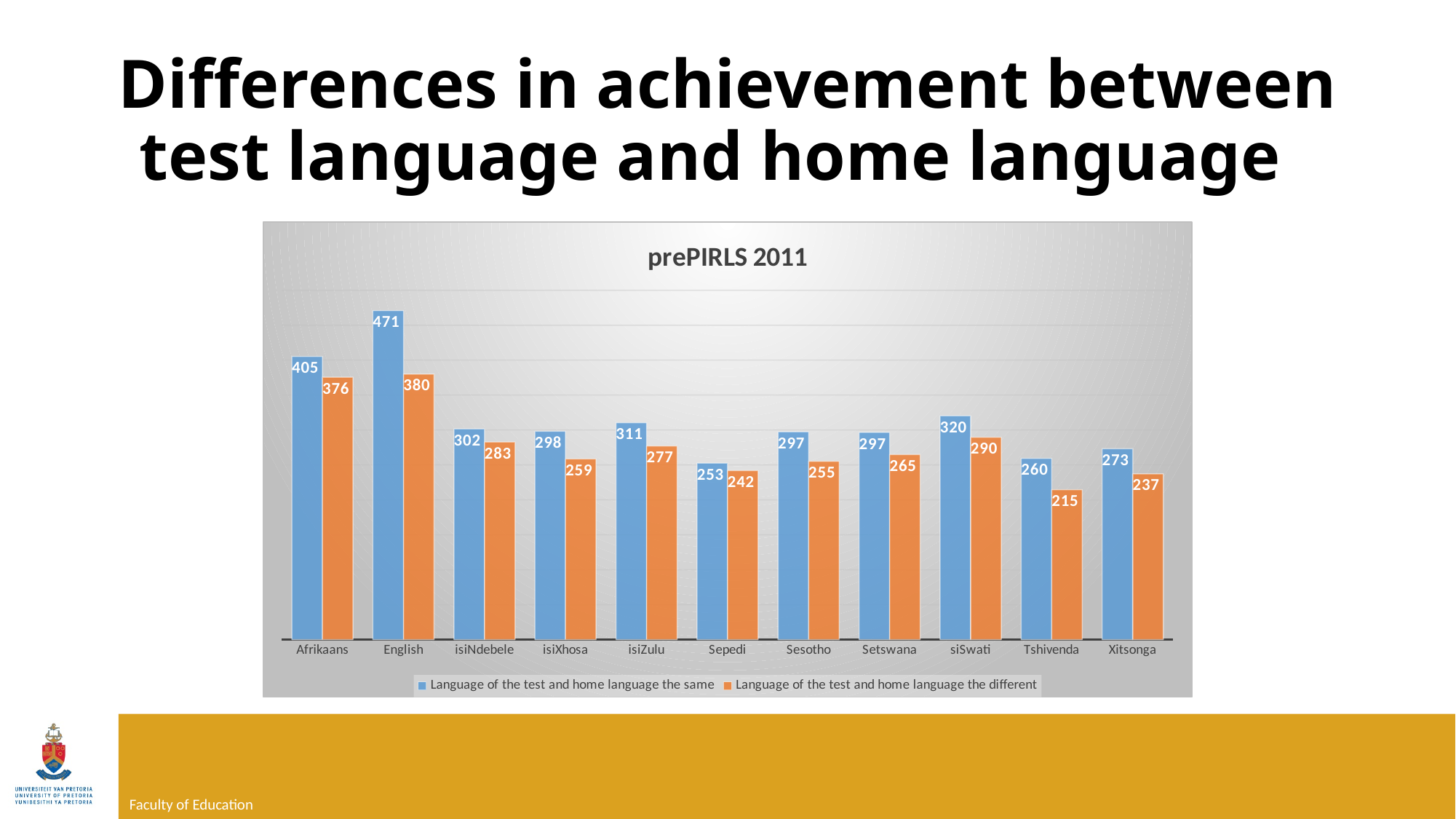
Which is larger: the 'same' value for isiZulu or the 'same' value for isiNdebele? isiZulu What kind of chart is shown on the slide? Bar chart How many series does the legend list? 2 Which language has the lowest value in the 'Language of the test and home language the different' series? Tshivenda What is the title of the chart? prePIRLS 2011 What is the value for English in the 'Language of the test and home language the same' series? 471 How many languages are shown on the x axis? 11 What is the difference between the two series for Sepedi? 11 What is the value for Tshivenda in the 'Language of the test and home language the different' series? 215 What is the difference between the two series for English? 91 Which language has the highest value in the 'Language of the test and home language the same' series? English What is the value for siSwati in the 'Language of the test and home language the different' series? 290